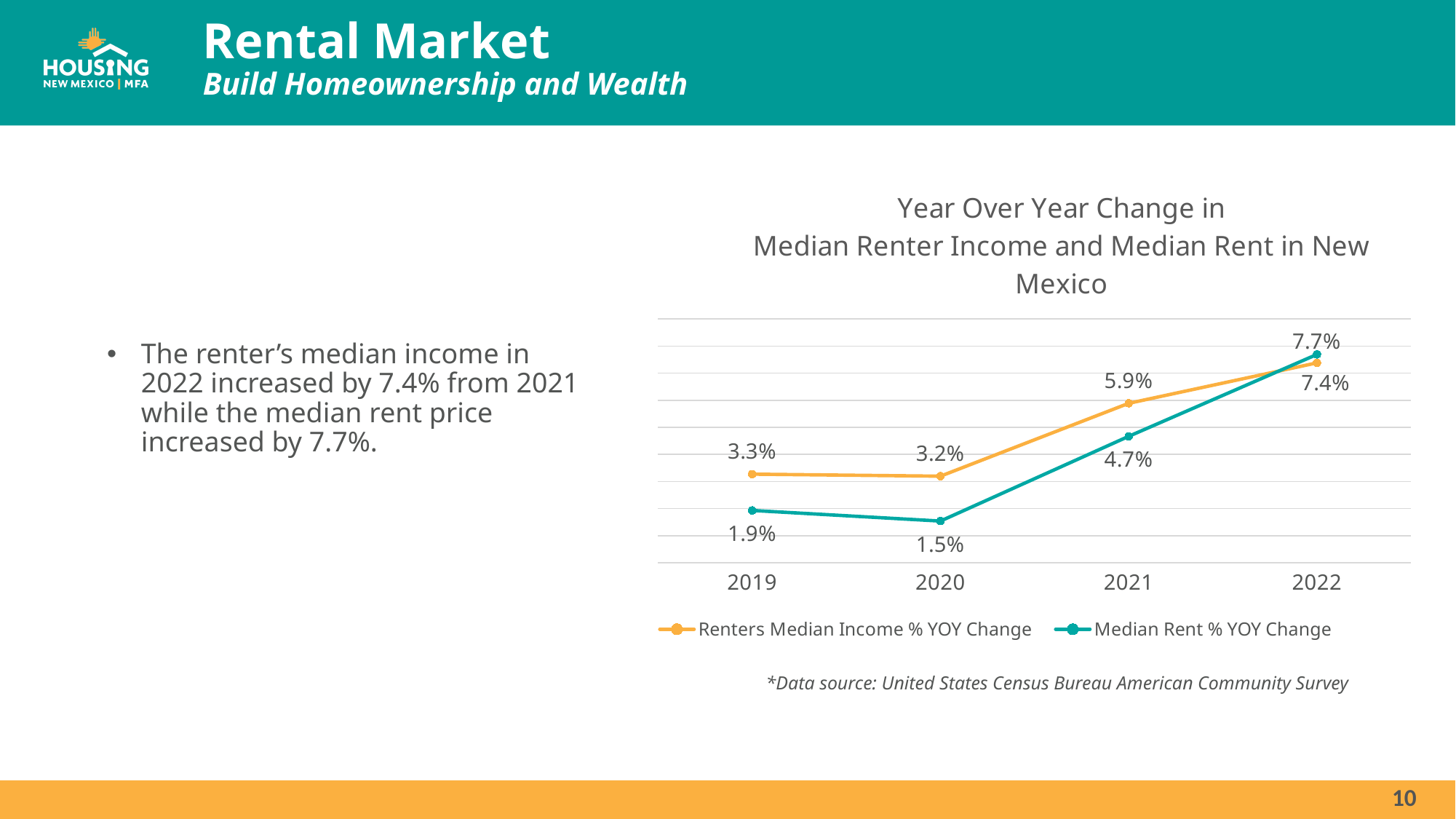
How many series does the chart's legend list? 2 What colour is the line for Median Rent % YOY Change? Teal What is the difference between the Median Rent % YOY Change and the Renters Median Income % YOY Change in 2021? 1.2% In which year is the Median Rent % YOY Change lowest? 2020 What is the Median Rent % YOY Change for 2020? 1.5% In 2019, which is larger: the Renters Median Income % YOY Change or the Median Rent % YOY Change? Renters Median Income % YOY Change Does the Median Rent % YOY Change rise or fall from 2020 to 2022? Rise What is the Median Rent % YOY Change for 2022? 7.7% What is the Renters Median Income % YOY Change for 2021? 5.9% In which year is the Renters Median Income % YOY Change highest? 2022 How many years are shown on the x axis of the chart? 4 What kind of chart is shown on the slide? Line chart